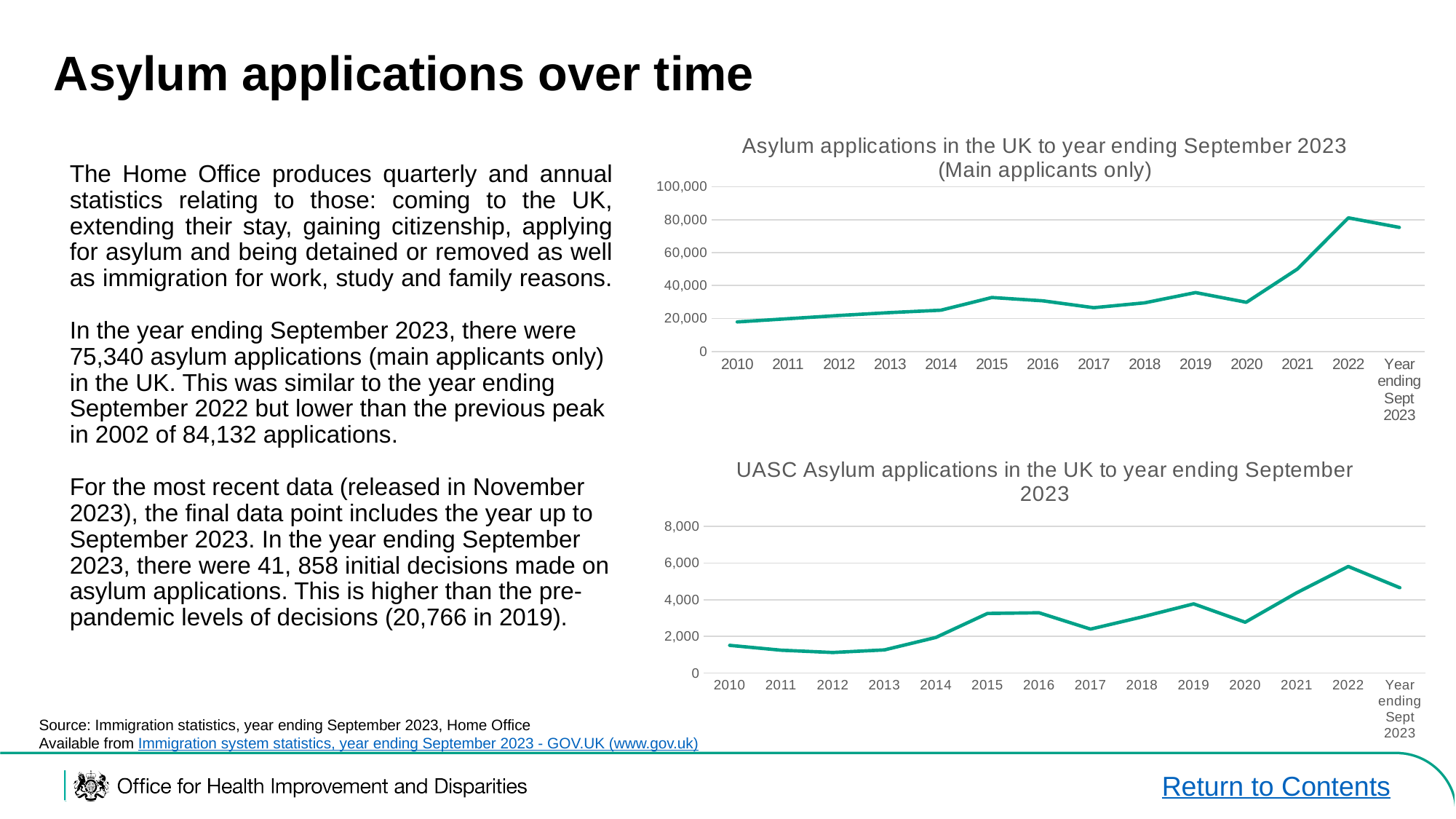
In the top chart (main applicants only), which year has the highest number of asylum applications? 2022 In the top chart (main applicants only), is the value for 2010 greater or less than 20,000? less What kind of chart is the top chart, 'Asylum applications in the UK to year ending September 2023 (Main applicants only)'? Line chart What kind of chart is the bottom chart, 'UASC Asylum applications in the UK to year ending September 2023'? Line chart In the top chart (main applicants only), is the value for 2022 greater or less than 60,000? greater In the bottom chart (UASC asylum applications), is the value for 2022 greater or less than 4,000? greater How many data points are plotted on the top chart (main applicants only)? 14 In the top chart (main applicants only), do asylum applications generally rise or fall from 2010 to 2022? Rise In the bottom chart (UASC asylum applications), which year has the highest value? 2022 In the bottom chart (UASC asylum applications), which is larger, the value for 2019 or the value for 2020? 2019 In the top chart (main applicants only), which year has the lowest number of asylum applications? 2010 In the bottom chart (UASC asylum applications), which year has the lowest value? 2012